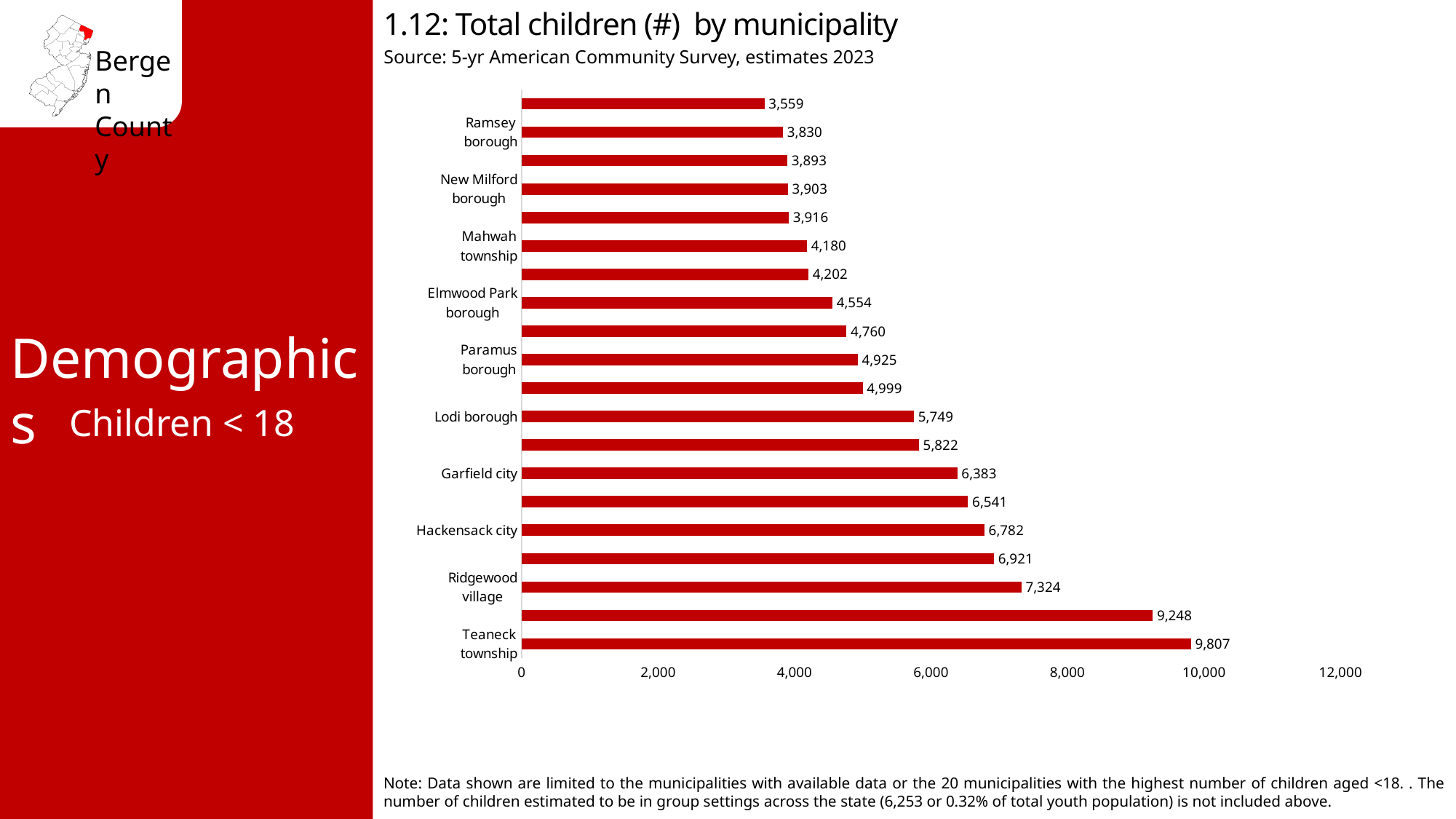
Which labelled municipality has the highest number of children? Teaneck township What is the total number of children for Teaneck township? 9,807 Which has more children, Lodi borough or Mahwah township? Lodi borough What is the total number of children for Hackensack city? 6,782 Is the value for Ridgewood village greater or less than 8,000? less How many bars are plotted on the chart? 20 What kind of chart is shown on the slide? Bar chart What is the total number of children for Paramus borough? 4,925 What is the total number of children for Ramsey borough? 3,830 What is the difference in number of children between Hackensack city and Garfield city? 399 What is the value of the shortest bar on the chart? 3,559 What is the difference in number of children between Teaneck township and Ridgewood village? 2,483